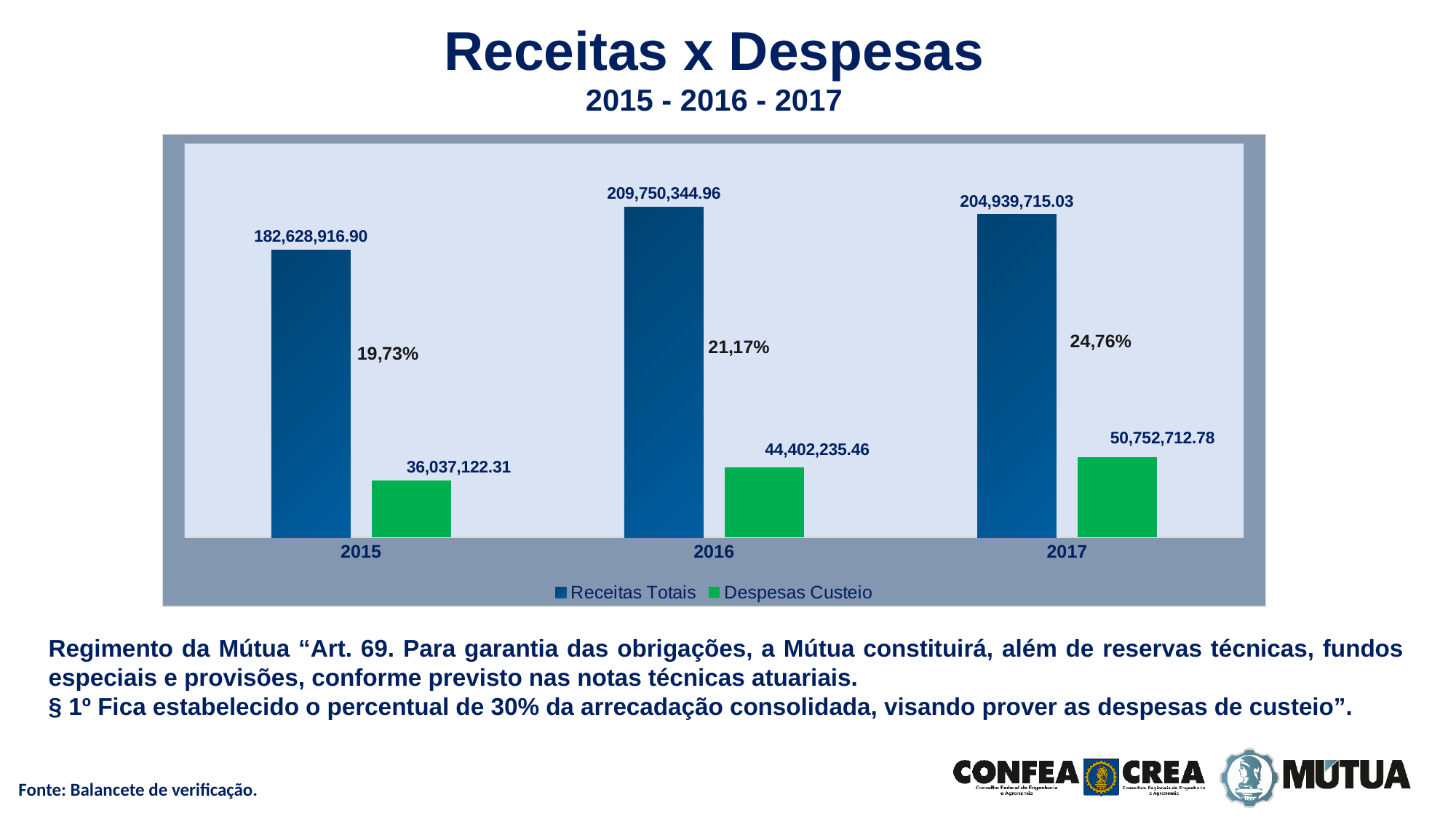
Which year has the highest Receitas Totais? 2016 What is the difference between Despesas Custeio in 2017 and in 2016? 6,350,477.32 Which year has the lowest Despesas Custeio? 2015 How many years are shown on the x axis? 3 Which is larger: Receitas Totais in 2017 or Receitas Totais in 2015? Receitas Totais in 2017 What is the value of Receitas Totais for 2016? 209,750,344.96 What percentage is shown for 2017? 24,76% How many series does the legend list? 2 What is the difference between Receitas Totais in 2016 and in 2015? 27,121,428.06 Do the Despesas Custeio values rise or fall from 2015 to 2017? rise What is the value of Despesas Custeio for 2017? 50,752,712.78 What is the value of Despesas Custeio for 2015? 36,037,122.31